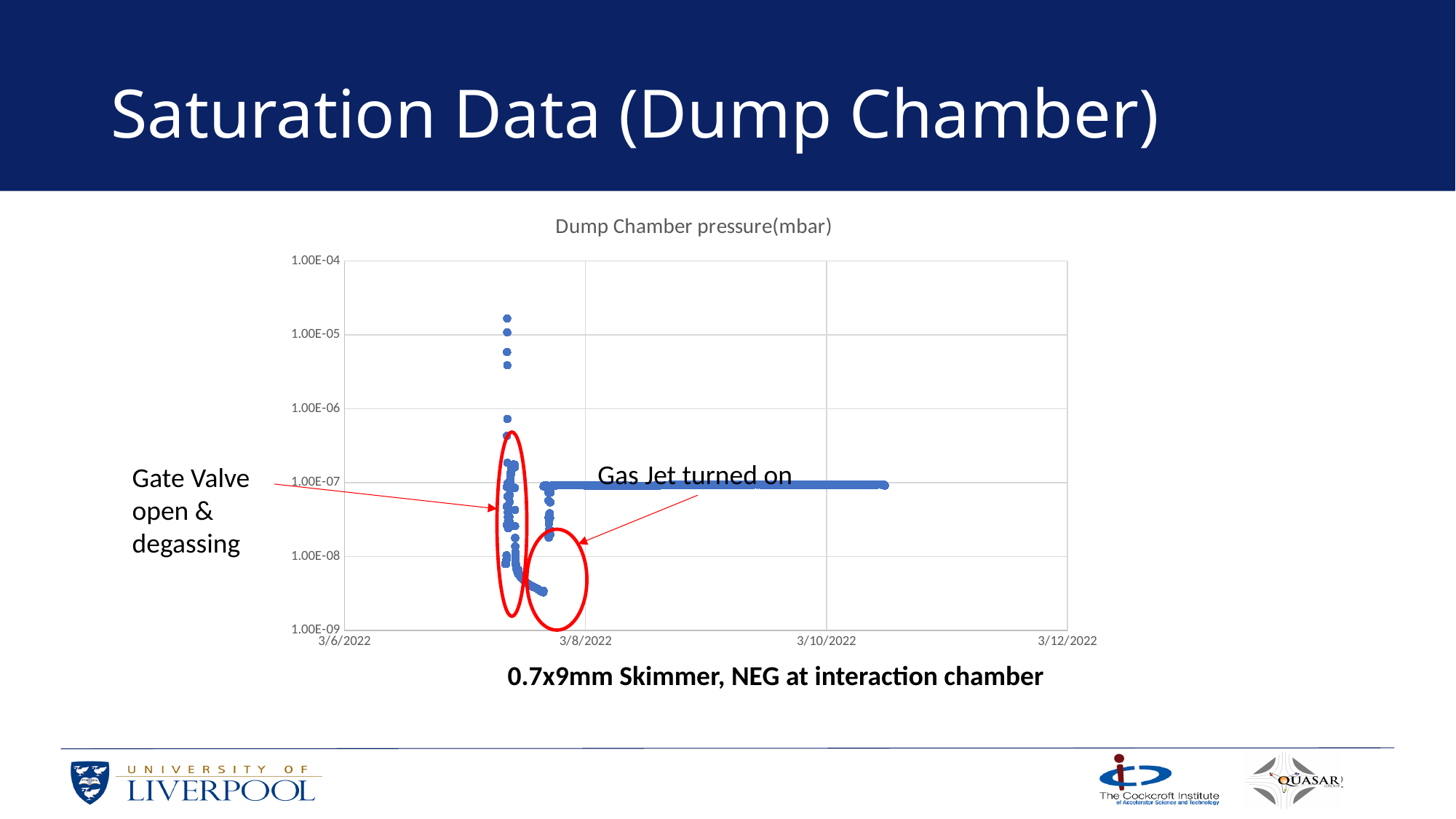
What is the lowest value labelled on the y axis of the chart? 1.00E-09 What event does the annotation near 3/8/2022 say caused the change in pressure? Gas Jet turned on Does the pressure rise or fall over the period labelled 'Gate Valve open & degassing'? fall What kind of chart is shown on the slide? scatter chart What is the highest value labelled on the y axis of the chart? 1.00E-04 What is the title of the chart? Dump Chamber pressure(mbar) Is the highest plotted pressure value greater or less than 1.00E-05? greater What is the first date labelled on the x axis of the chart? 3/6/2022 How many date labels are shown on the x axis of the chart? 4 Is the pressure during the long flat section after 3/8/2022 greater or less than 1.00E-06? less What is the last date labelled on the x axis of the chart? 3/12/2022 Is the lowest plotted pressure value greater or less than 1.00E-08? less